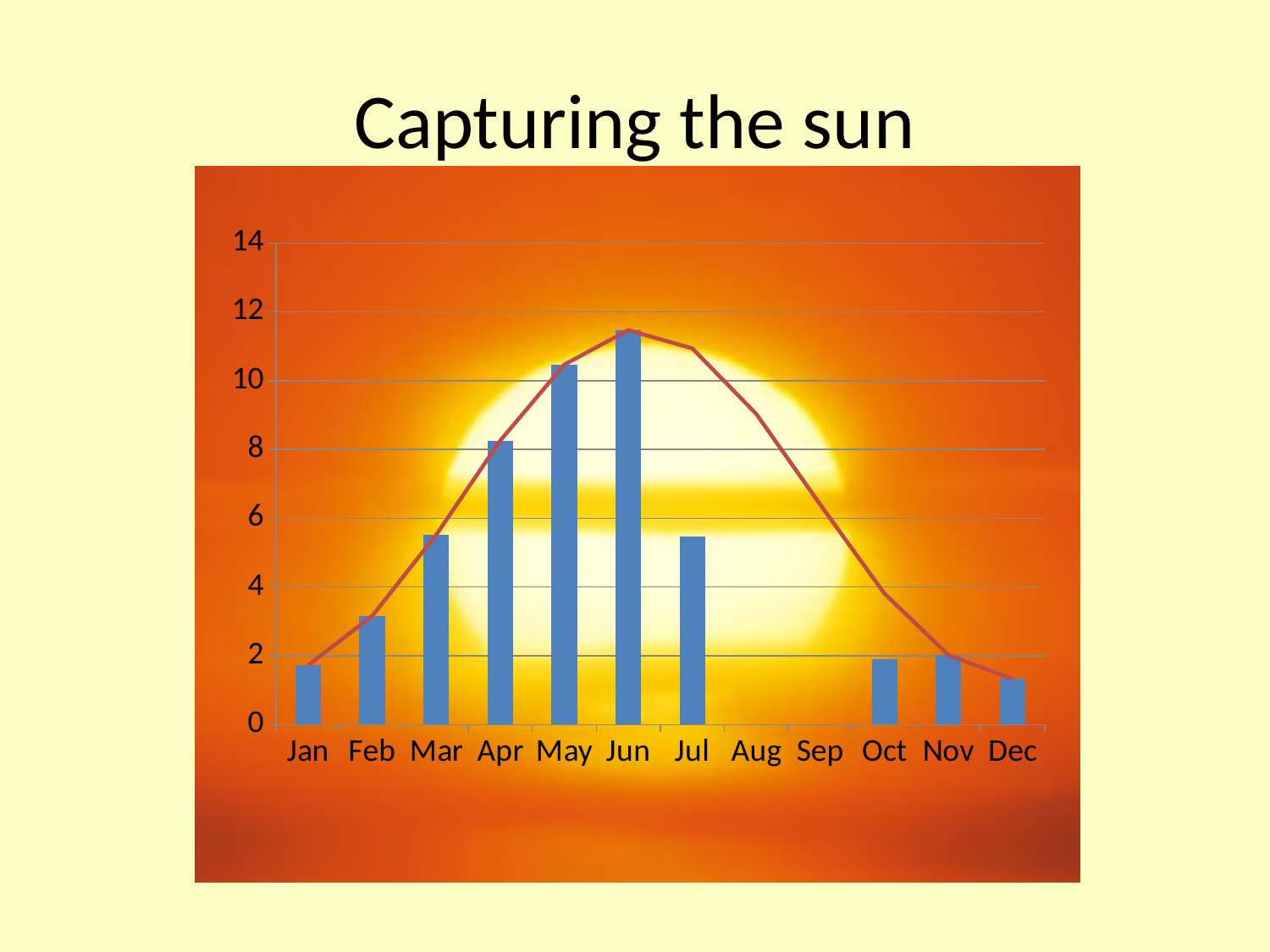
Is the bar value for Jun greater or less than 10? greater Does the line rise or fall from Jun to Dec? fall Which month has the shortest bar? Dec How many months are shown on the x axis? 12 Is the bar value for Feb greater or less than 4? less Which months have no bar plotted? Aug and Sep Is the bar value for Mar greater or less than 6? less Do the bar values rise or fall from Jan to Jun? rise Which month has the tallest bar? Jun What kind of chart is shown on the slide? bar chart with a line Which bar is taller, May or Jul? May